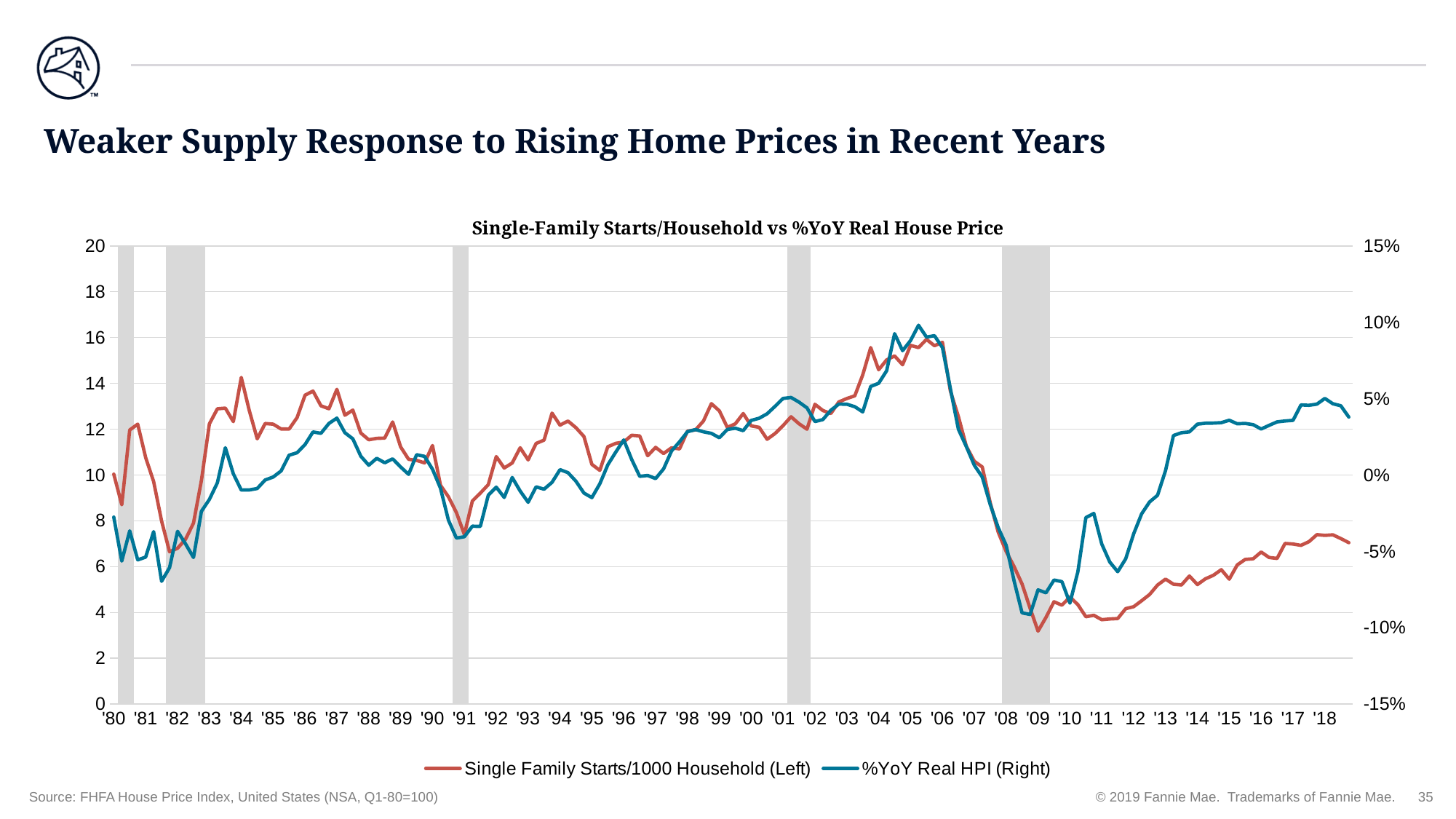
Is the value for %YoY Real HPI in '09 greater or less than -5%? less Is the value for Single Family Starts/1000 Household in '18 greater or less than 10? less Does the Single Family Starts/1000 Household series rise or fall from '06 to '09? fall Does the %YoY Real HPI series rise or fall from '12 to '14? rise Is the value for Single Family Starts/1000 Household in '86 greater or less than 12? greater Which is larger for Single Family Starts/1000 Household: the value in '86 or the value in '11? '86 How many series does the legend list? 2 What kind of chart is shown on the slide? line chart What is the title of the chart? Single-Family Starts/Household vs %YoY Real House Price Which series is plotted against the right-hand axis? %YoY Real HPI (Right)